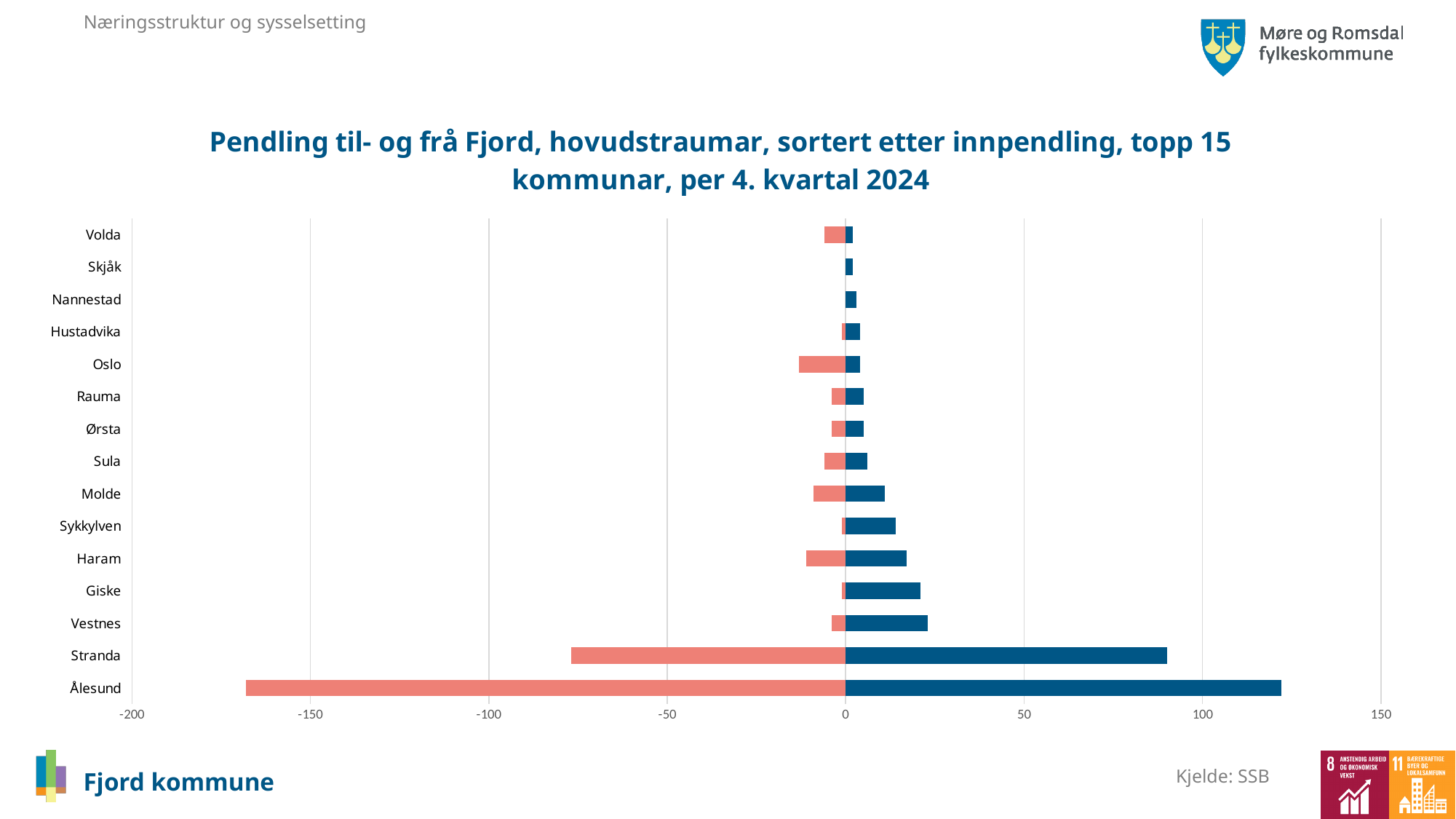
How many municipalities are listed on the vertical axis of the chart? 15 Which has the longer blue bar, Stranda or Ålesund? Ålesund Is the red bar value for Ålesund greater or less than -150? less Which has the longer red bar, Oslo or Volda? Oslo Which municipality has the longest blue (positive) bar? Ålesund Is the blue bar value for Stranda greater or less than 100? less Which municipality has the longest red (negative) bar? Ålesund What is the title of the chart? Pendling til- og frå Fjord, hovudstraumar, sortert etter innpendling, topp 15 kommunar, per 4. kvartal 2024 Is the blue bar value for Vestnes greater or less than 50? less What kind of chart is shown on the slide? bar chart Which has the longer blue bar, Haram or Molde? Haram